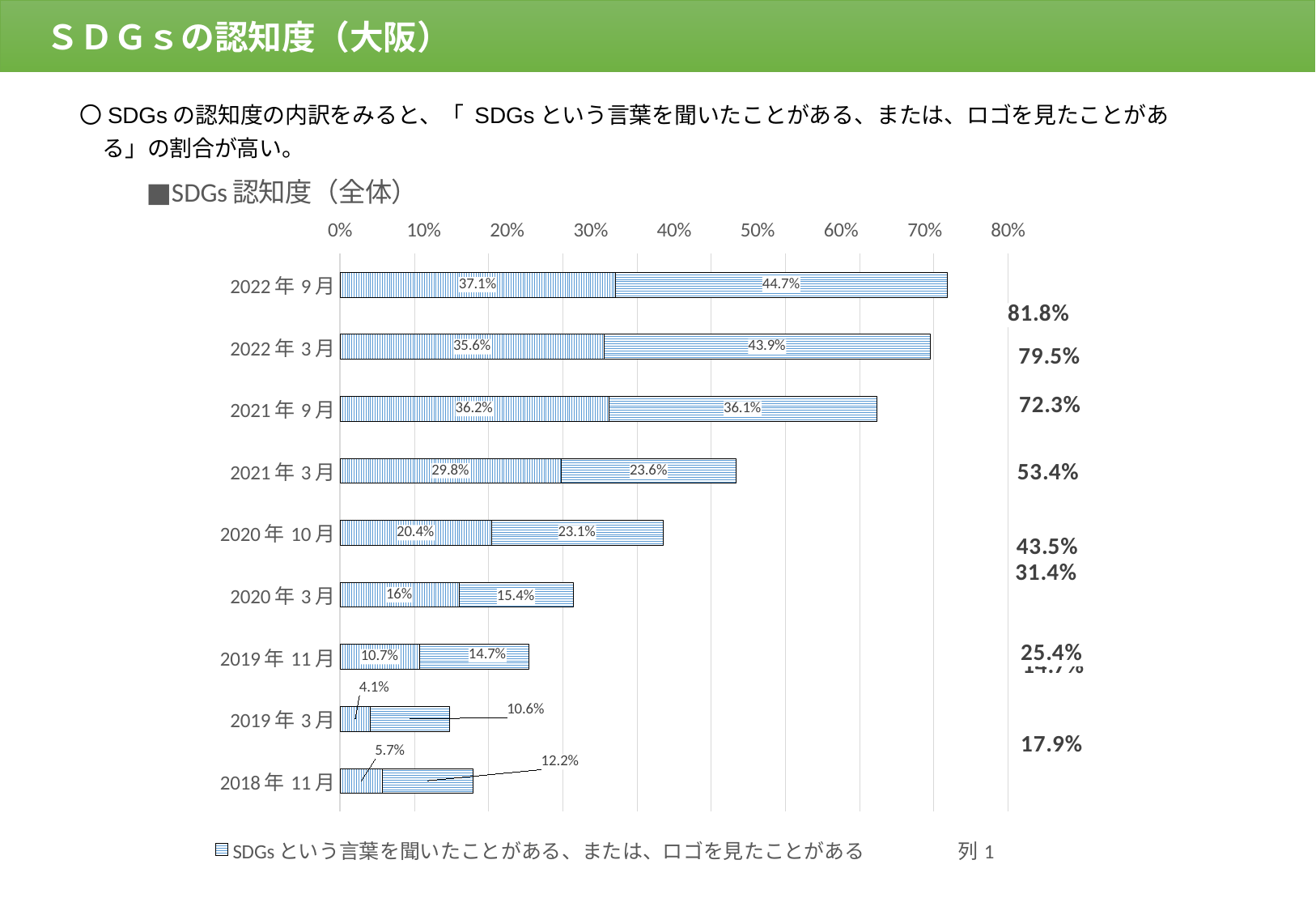
What is the difference between the second (right) segment values for 2022年3月 and 2021年3月? 20.3% What is the total of the stacked bar for 2021年3月? 53.4% Which is larger: the first (left) segment for 2020年3月 or the first (left) segment for 2019年11月? 2020年3月 What is the value of the first (left) segment of the bar for 2022年9月? 37.1% What is the value of the second (right) segment of the bar for 2021年9月? 36.1% How many series does the legend list? 2 What is the value of the second (right) segment of the bar for 2022年9月? 44.7% What kind of chart is shown on the slide? bar chart What is the value of the first (left) segment of the bar for 2018年11月? 5.7% What is the total of the stacked bar for 2020年10月? 43.5% How many time-period categories are plotted on the chart? 9 Which time period has the longest total bar? 2022年9月